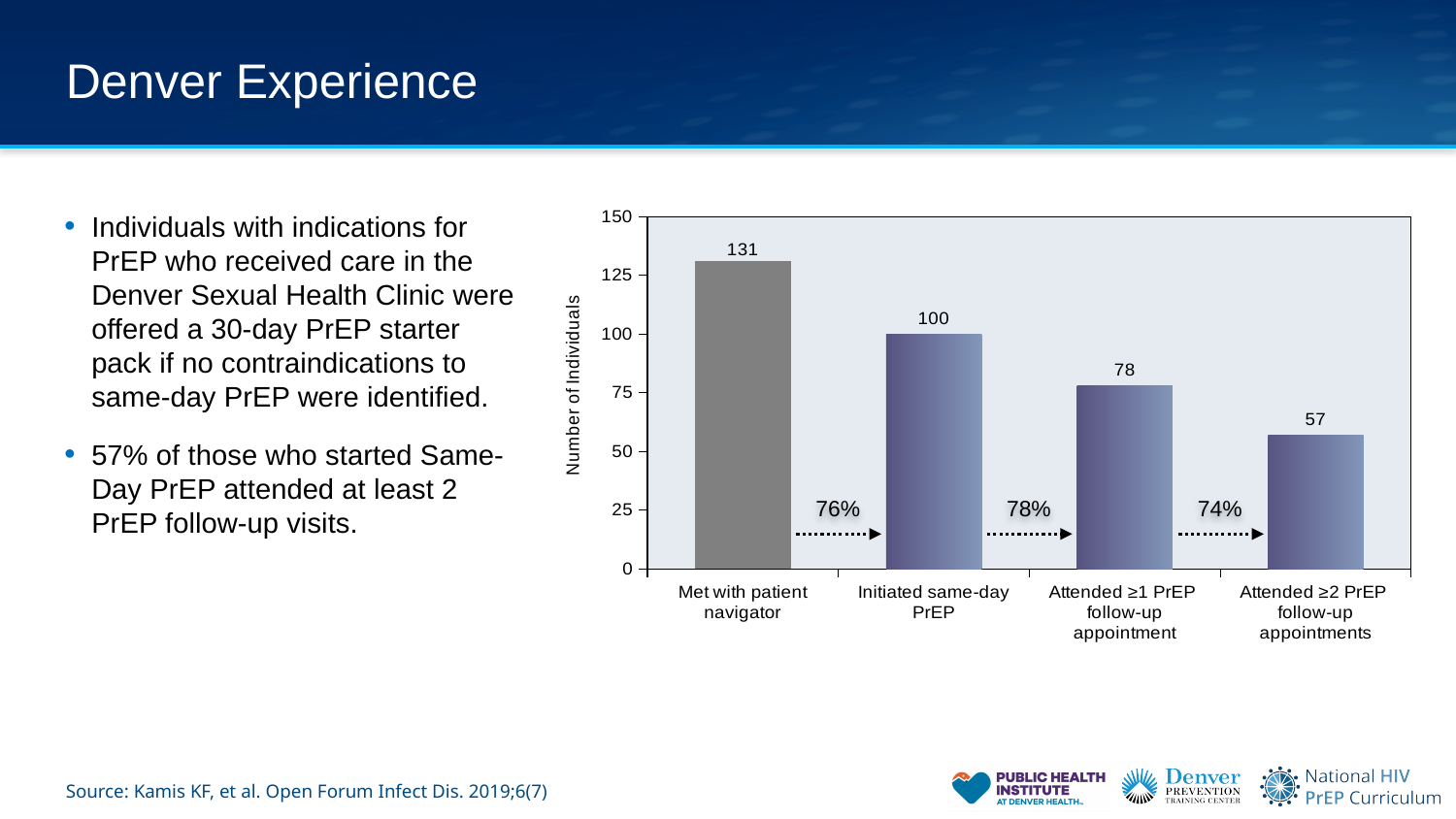
Do the values rise or fall from left to right across the chart? Fall What percentage is shown between the 'Initiated same-day PrEP' bar and the 'Attended ≥1 PrEP follow-up appointment' bar? 78% How many individuals met with a patient navigator? 131 What kind of chart is shown on the slide? Bar chart What is the difference between the number who attended ≥1 PrEP follow-up appointment and the number who attended ≥2 PrEP follow-up appointments? 21 Which category has the lowest number of individuals? Attended ≥2 PrEP follow-up appointments How many categories are shown on the x axis of the chart? 4 Which is larger: the number who initiated same-day PrEP or the number who attended ≥1 PrEP follow-up appointment? Initiated same-day PrEP What is the difference between the number who met with a patient navigator and the number who initiated same-day PrEP? 31 Which category has the highest number of individuals? Met with patient navigator How many individuals initiated same-day PrEP? 100 How many individuals attended ≥2 PrEP follow-up appointments? 57